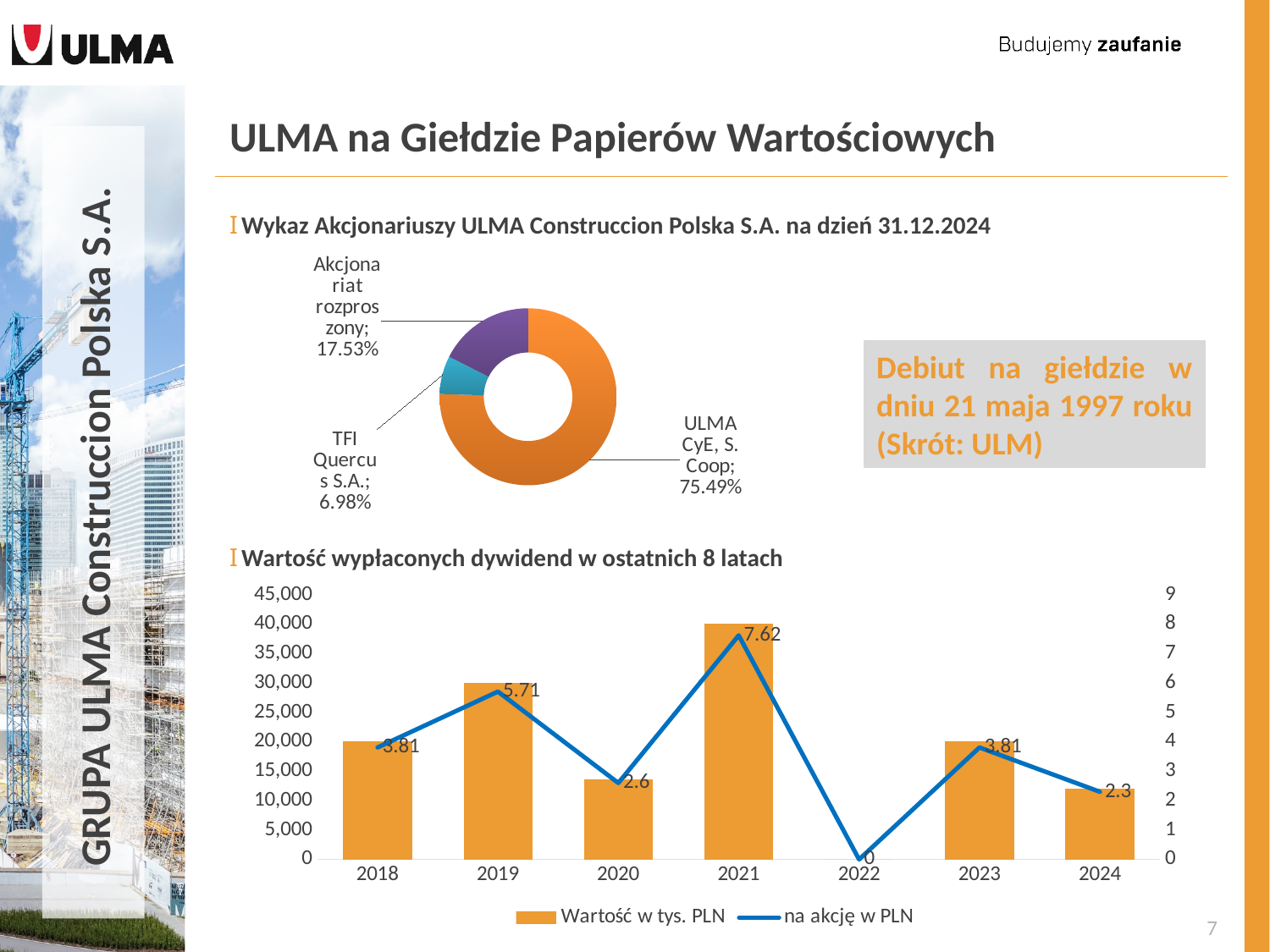
In the shareholder chart (Wykaz Akcjonariuszy), how many shareholder categories are shown? 3 In the dividend chart (Wartość wypłaconych dywidend), is the 'Wartość w tys. PLN' bar for 2021 greater or less than 35,000? greater In the shareholder chart (Wykaz Akcjonariuszy), what is the difference between the share of Akcjonariat rozproszony and TFI Quercus S.A.? 10.55% In the dividend chart (Wartość wypłaconych dywidend), what is the value of 'na akcję w PLN' for 2021? 7.62 In the dividend chart (Wartość wypłaconych dywidend), what is the difference in 'na akcję w PLN' between 2019 and 2020? 3.11 In the shareholder chart (Wykaz Akcjonariuszy), what share does TFI Quercus S.A. hold? 6.98% In the shareholder chart (Wykaz Akcjonariuszy), which shareholder has the smallest share? TFI Quercus S.A. In the dividend chart (Wartość wypłaconych dywidend), which year has the highest dividend per share (na akcję w PLN)? 2021 In the shareholder chart (Wykaz Akcjonariuszy), what share does ULMA CyE, S. Coop hold? 75.49% In the dividend chart (Wartość wypłaconych dywidend), does the 'na akcję w PLN' line rise or fall from 2021 to 2022? fall In the dividend chart (Wartość wypłaconych dywidend), what is the value of 'na akcję w PLN' for 2024? 2.3 In the dividend chart (Wartość wypłaconych dywidend), how many series does the legend list? 2